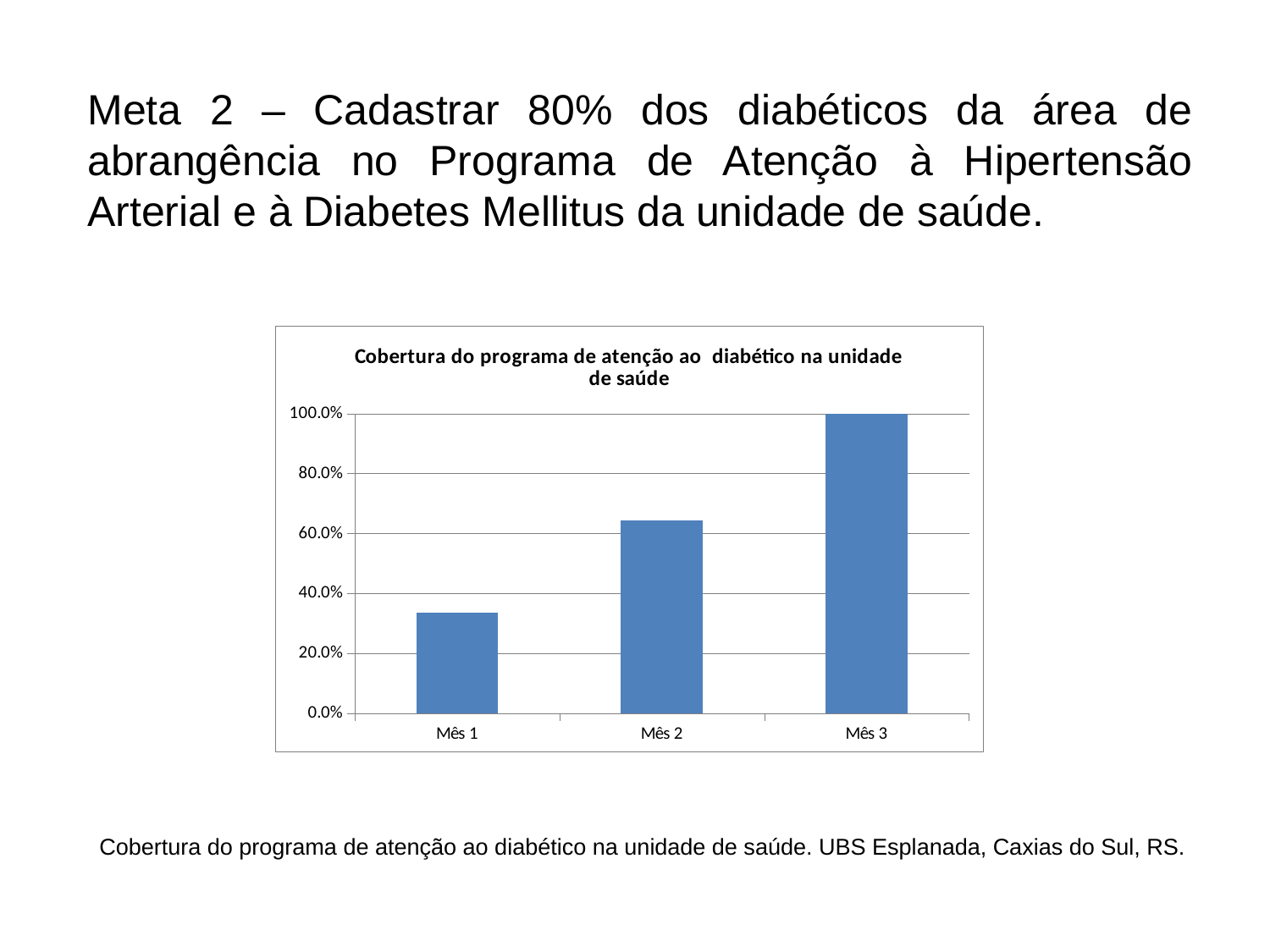
Which month has the lowest coverage value in the chart? Mês 1 Is the value for Mês 2 greater or less than 60.0%? greater How many categories (months) are shown on the x axis of the chart? 3 What type of chart is shown on the slide? bar chart Do the values rise or fall from Mês 1 to Mês 3? rise Is the value for Mês 1 greater or less than 20.0%? greater Is the value for Mês 1 greater or less than 40.0%? less Which month has the highest coverage value in the chart? Mês 3 What is the coverage value for Mês 3? 100.0% What is the title of the chart? Cobertura do programa de atenção ao diabético na unidade de saúde Which is larger, the value for Mês 1 or the value for Mês 2? Mês 2